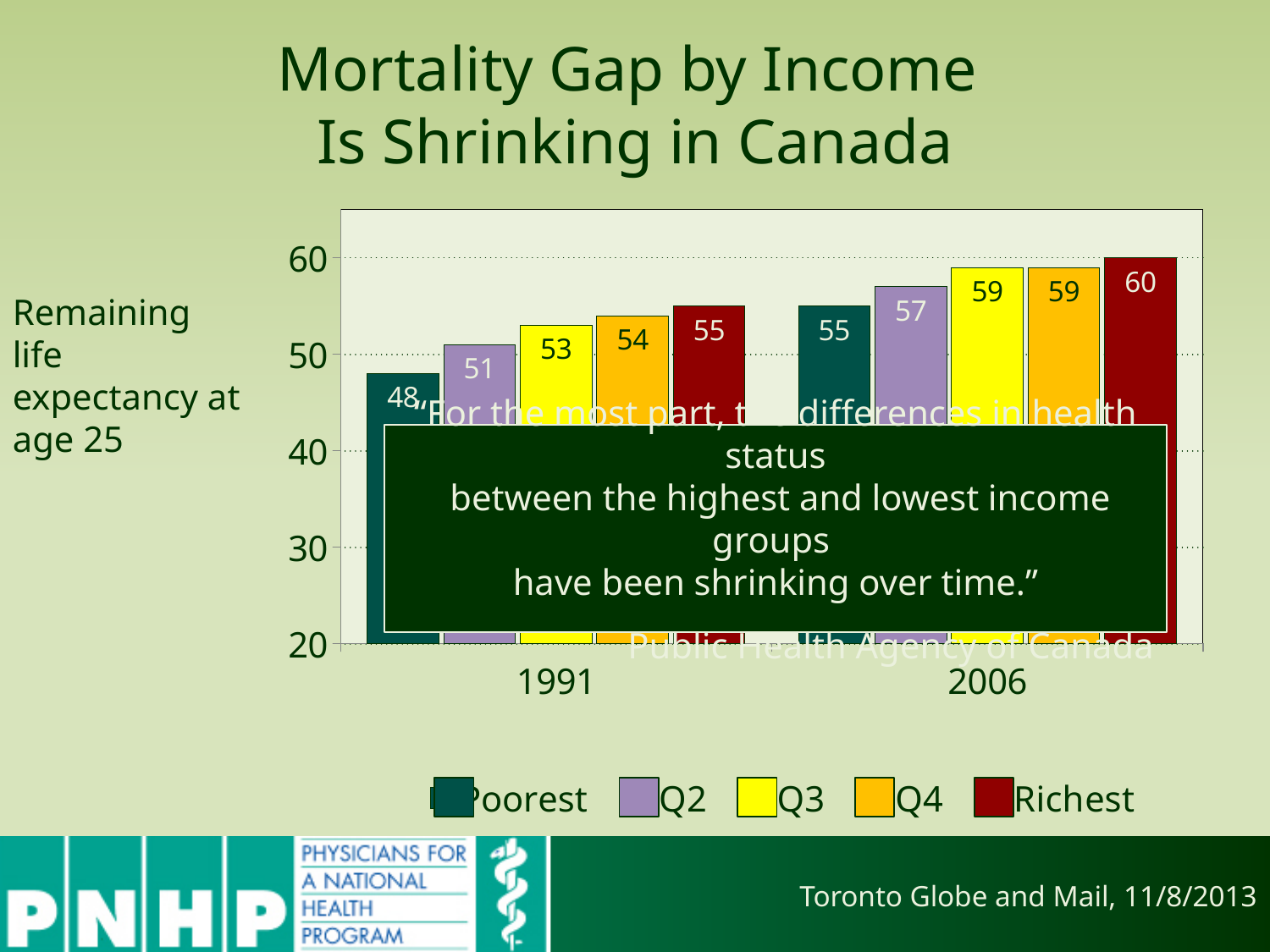
What is the remaining life expectancy at age 25 for the Poorest group in 1991? 48 What is the value for the Richest group in 2006? 60 What is the value for Q2 in 2006? 57 How many year categories are shown on the x axis? 2 Which is larger: the Poorest value in 2006 or the Q4 value in 1991? Poorest value in 2006 What is the difference between the Richest and Poorest values in 2006? 5 Which income group has the highest value in 2006? Richest Does the value for the Poorest group rise or fall from 1991 to 2006? Rise Which income group has the lowest value in 1991? Poorest What kind of chart is shown on the slide? Bar chart What is the difference between the Richest and Poorest values in 1991? 7 How many series does the legend list? 5